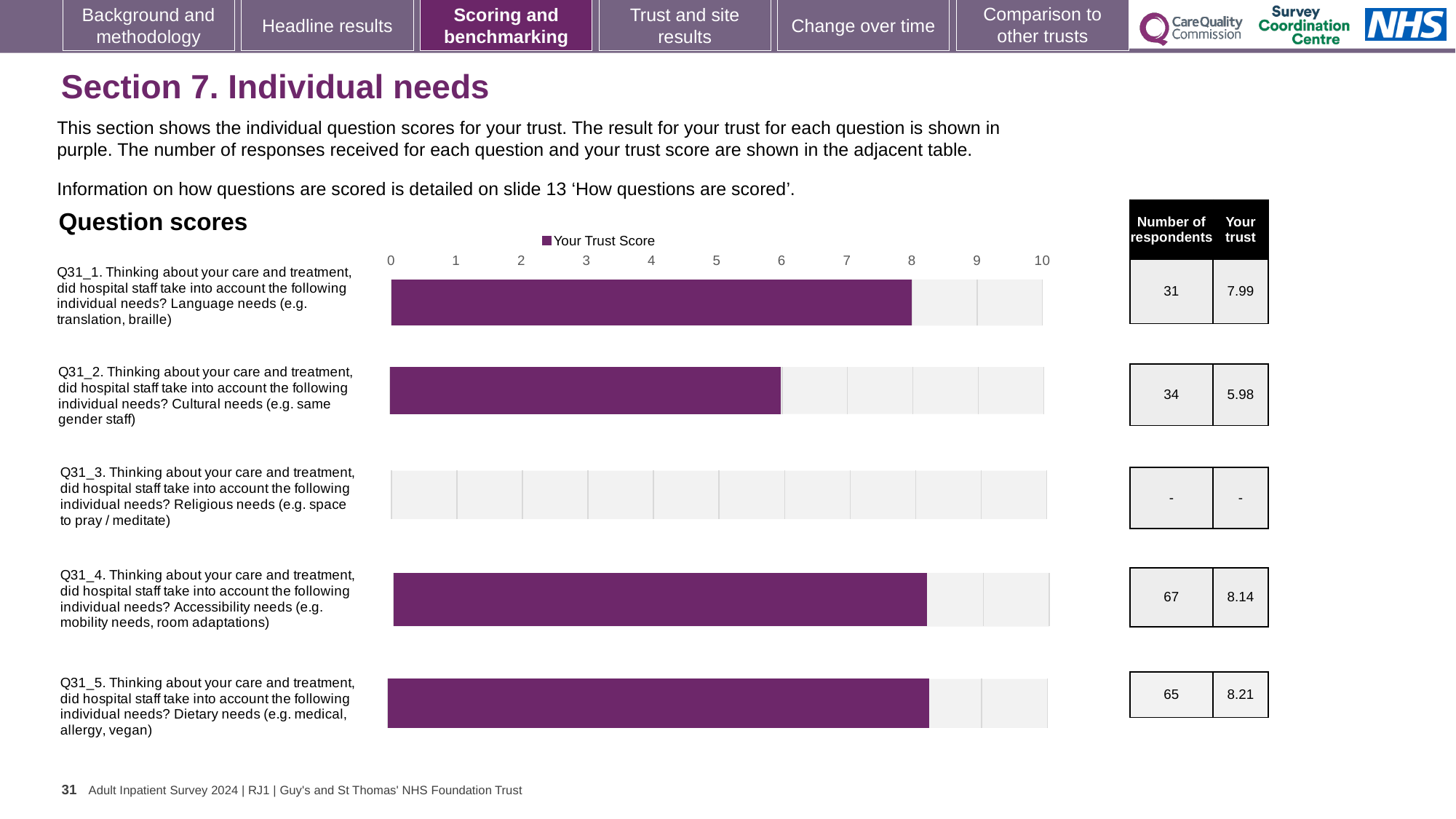
How many questions are listed in the chart? 5 What type of chart is used to show the question scores? Bar chart Which has a higher trust score, Q31_1 (Language needs) or Q31_2 (Cultural needs)? Q31_1 (Language needs) How many respondents answered Q31_4 (Accessibility needs)? 67 What is the trust score for Q31_2 (Cultural needs)? 5.98 Among the questions with a plotted score, which has the lowest trust score? Q31_2 (Cultural needs) What is the difference between the trust scores for Q31_4 and Q31_2? 2.16 What is the trust score for Q31_1 (Language needs)? 7.99 What series does the chart legend show? Your Trust Score Which question has the highest trust score? Q31_5 (Dietary needs) Is the trust score for Q31_2 (Cultural needs) greater or less than 7? less What is the trust score for Q31_5 (Dietary needs)? 8.21